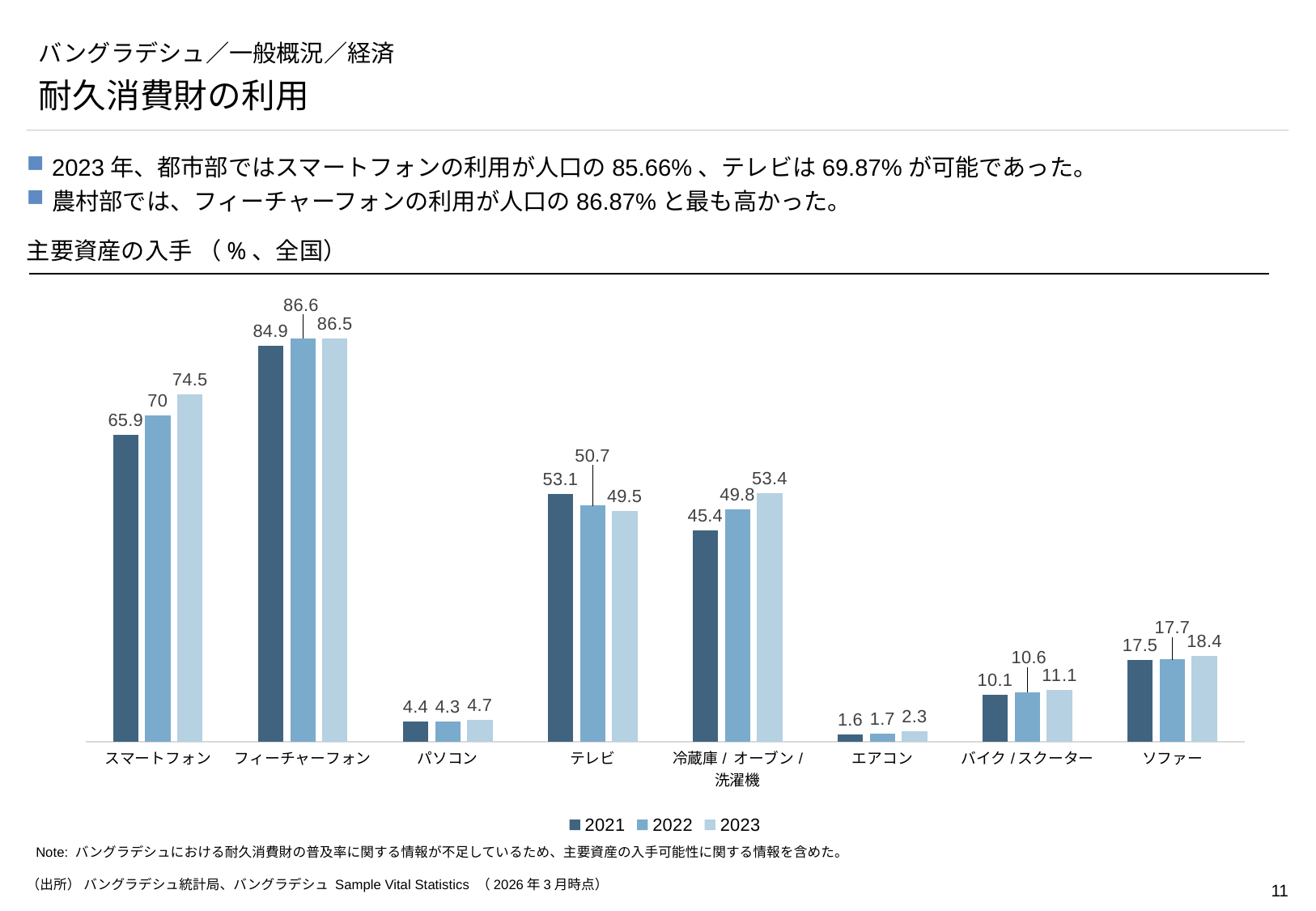
What is the value for テレビ in 2021? 53.1 How many series does the legend list? 3 What is the title of the chart? 主要資産の入手（%、全国） Which category has the lowest value in 2021? エアコン Which category has the highest value in 2023? フィーチャーフォン What is the value for エアコン in 2022? 1.7 Which is larger: the 2022 value for テレビ or the 2022 value for 冷蔵庫 / オーブン / 洗濯機? テレビ What kind of chart is shown on the slide? Bar chart What is the value for スマートフォン in 2023? 74.5 How many categories are shown on the x axis? 8 What is the difference between the 2023 and 2021 values for スマートフォン? 8.6 Do the values for ソファー rise or fall from 2021 to 2023? Rise